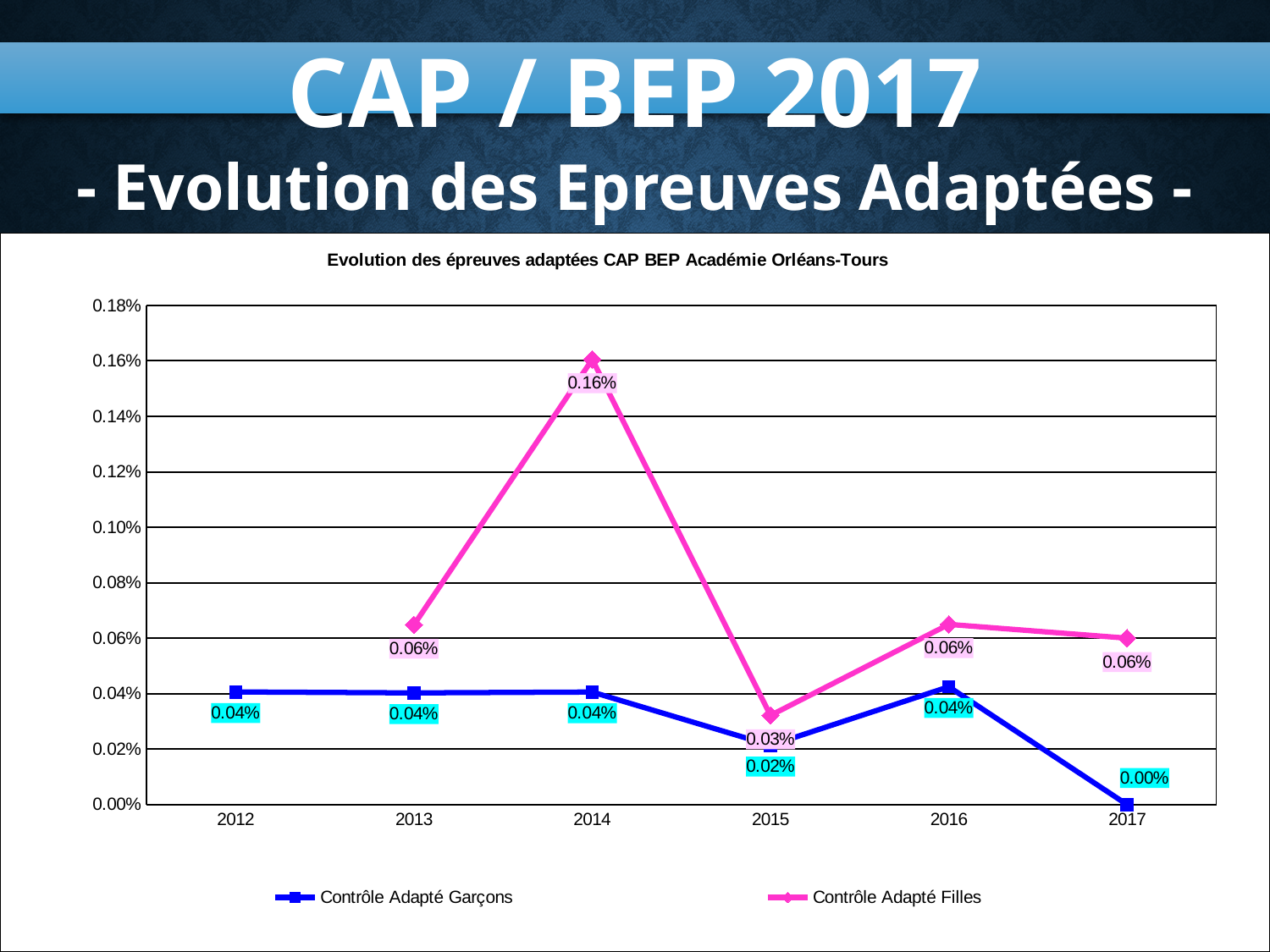
Does the value for Contrôle Adapté Garçons rise or fall from 2016 to 2017? fall What type of chart is shown on the slide? line chart How many years are shown on the x axis? 6 In which year is the value for Contrôle Adapté Filles highest? 2014 What is the difference between Contrôle Adapté Filles and Contrôle Adapté Garçons in 2014? 0.12% In which year is the value for Contrôle Adapté Garçons lowest? 2017 Which series has the larger value in 2016, Contrôle Adapté Garçons or Contrôle Adapté Filles? Contrôle Adapté Filles What is the value for Contrôle Adapté Garçons in 2017? 0.00% How many series does the legend list? 2 What is the value for Contrôle Adapté Filles in 2014? 0.16% What is the title of the chart? Evolution des épreuves adaptées CAP BEP Académie Orléans-Tours What is the value for Contrôle Adapté Garçons in 2015? 0.02%